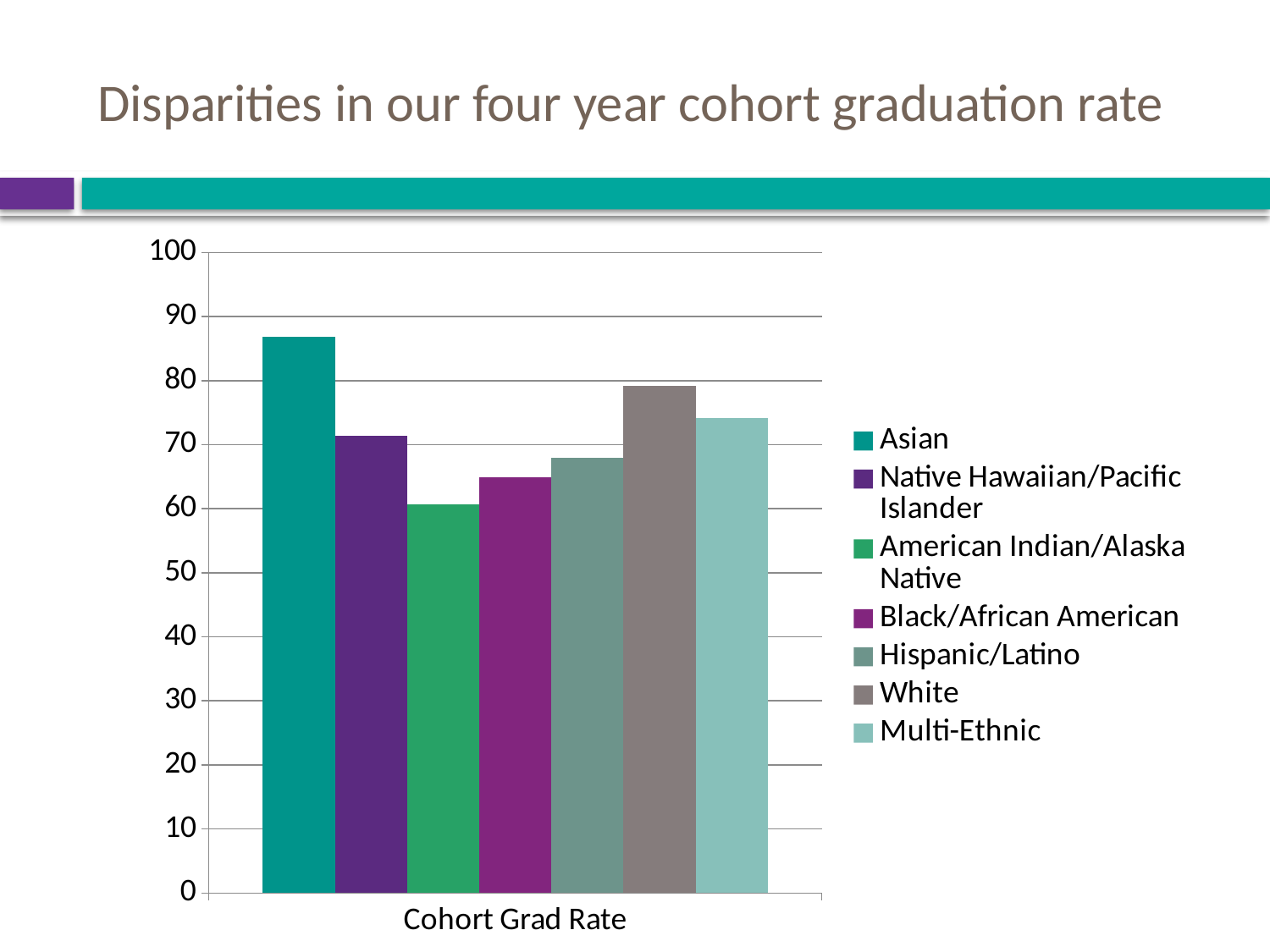
How many series does the legend list? 7 Which is larger, the cohort grad rate for Hispanic/Latino or for Black/African American? Hispanic/Latino Which is larger, the cohort grad rate for White or for Multi-Ethnic? White Which group has the highest cohort grad rate? Asian Which group has the lowest cohort grad rate? American Indian/Alaska Native Is the cohort grad rate for Multi-Ethnic greater or less than 70? greater What is the label on the x axis category? Cohort Grad Rate What kind of chart is shown on the slide? bar chart Is the cohort grad rate for Asian greater or less than 80? greater Is the cohort grad rate for Black/African American greater or less than 70? less What is the title of the slide containing the chart? Disparities in our four year cohort graduation rate